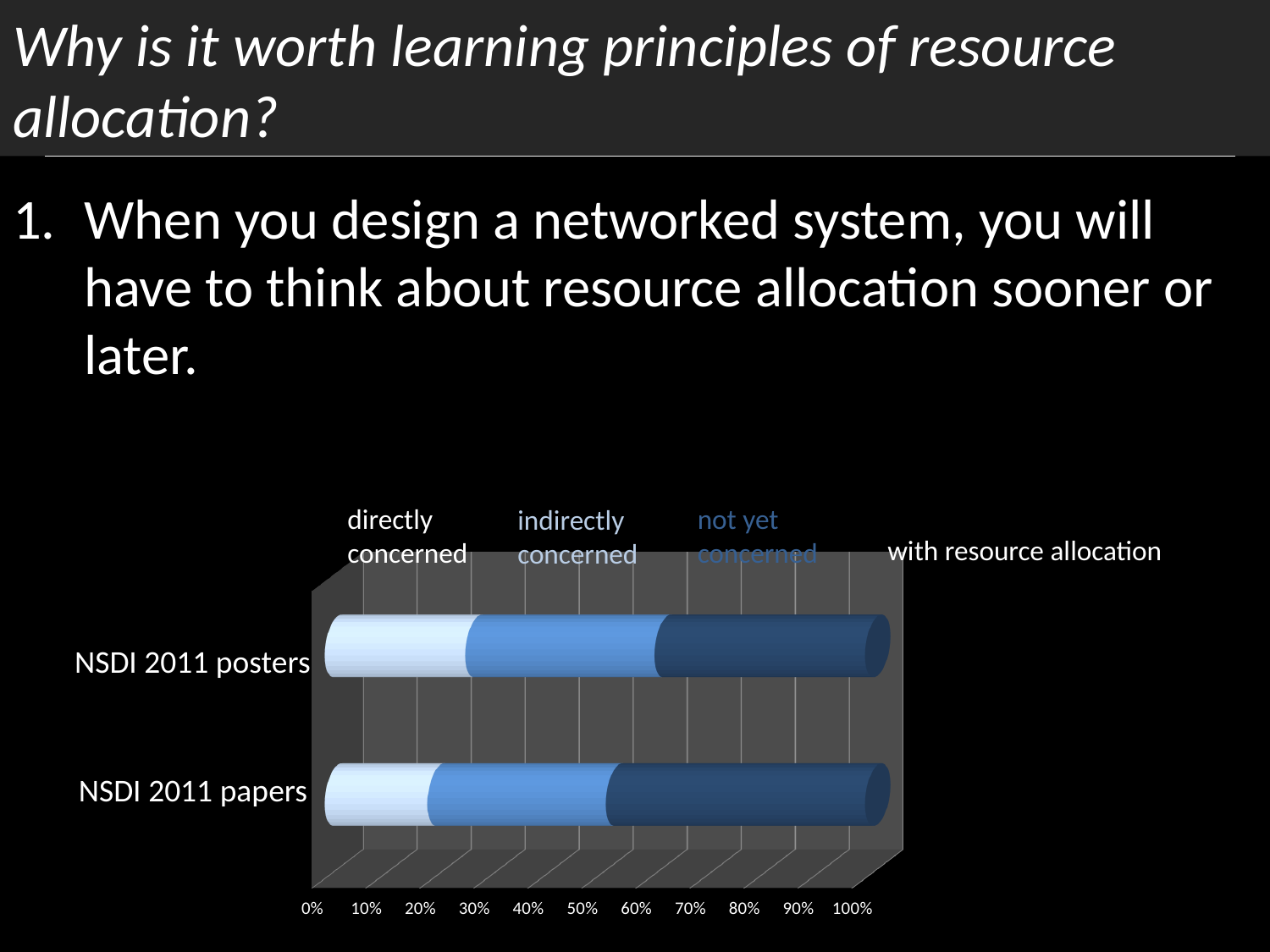
How many series does the chart's legend list? 3 Is the 'not yet concerned' share for NSDI 2011 posters greater or less than 60%? less Which category has the larger 'not yet concerned' share, NSDI 2011 posters or NSDI 2011 papers? NSDI 2011 papers What are the two categories shown on the chart's vertical axis? NSDI 2011 posters and NSDI 2011 papers Is the 'not yet concerned' share for NSDI 2011 papers greater or less than 30%? greater Is the 'directly concerned' share for NSDI 2011 papers greater or less than 30%? less How many categories are plotted on the chart? 2 What are the three series named in the chart's legend? directly concerned, indirectly concerned, not yet concerned What kind of chart is shown on the slide? stacked bar chart Which series forms the largest segment of the NSDI 2011 papers bar? not yet concerned Which category has the larger 'directly concerned' share, NSDI 2011 posters or NSDI 2011 papers? NSDI 2011 posters